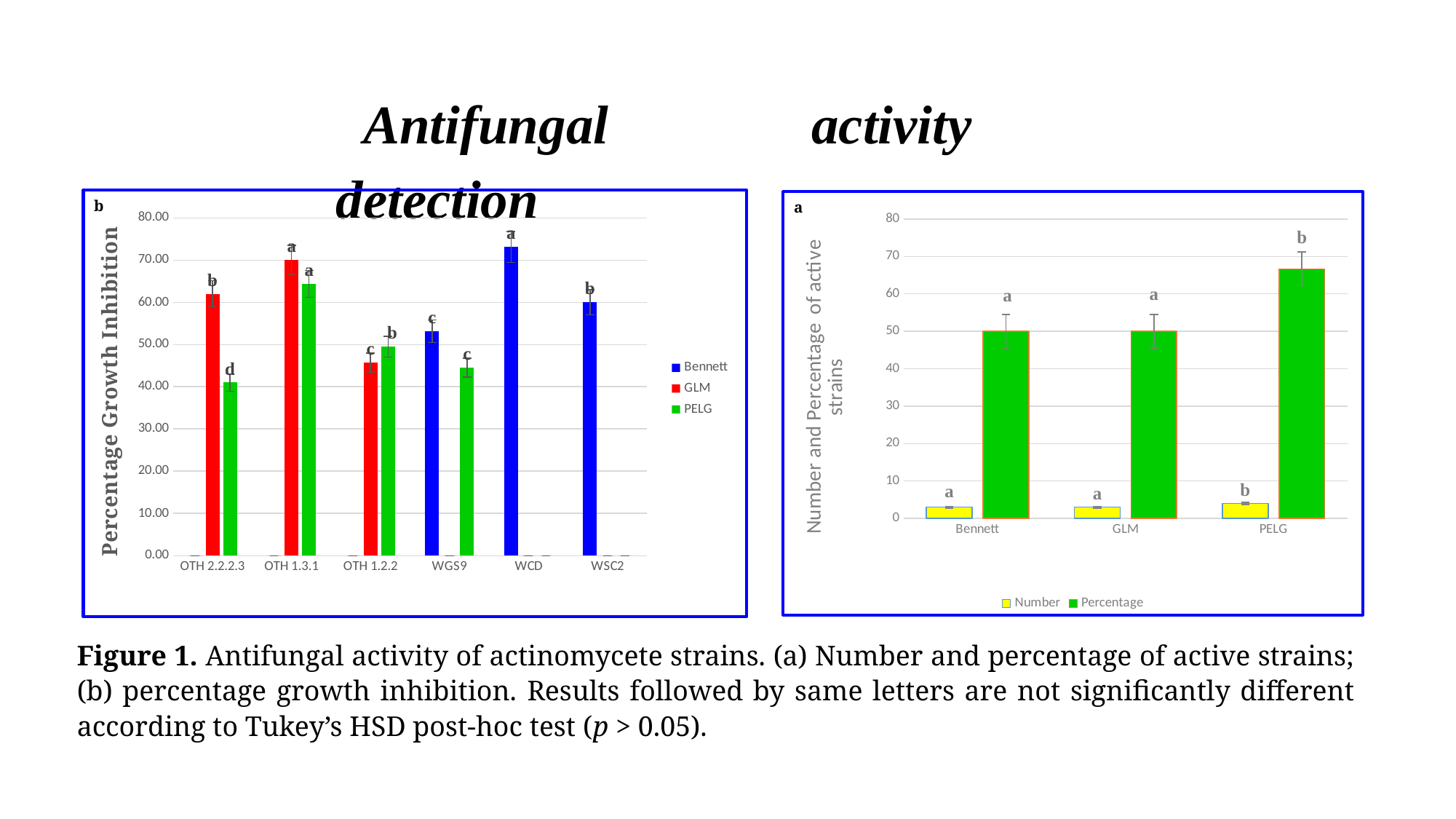
In the left chart (b), is the Bennett value for WCD greater or less than 70.00? greater How many series does the legend of the left chart (b) list? 3 How many strain categories are shown on the x axis of the left chart (b)? 6 In the left chart (b), is the PELG value for OTH 2.2.2.3 greater or less than 50.00? less In the left chart (b), which category has the highest Bennett value? WCD What kind of chart is the left chart (b), Percentage Growth Inhibition? bar chart In the right chart (a), which category has the highest Percentage value? PELG In the right chart (a), is the Percentage value for PELG greater or less than 60? greater In the left chart (b), which series is shown in red? GLM In the right chart (a), how many series does the legend list? 2 In the left chart (b), which is larger for OTH 2.2.2.3: the GLM value or the PELG value? GLM